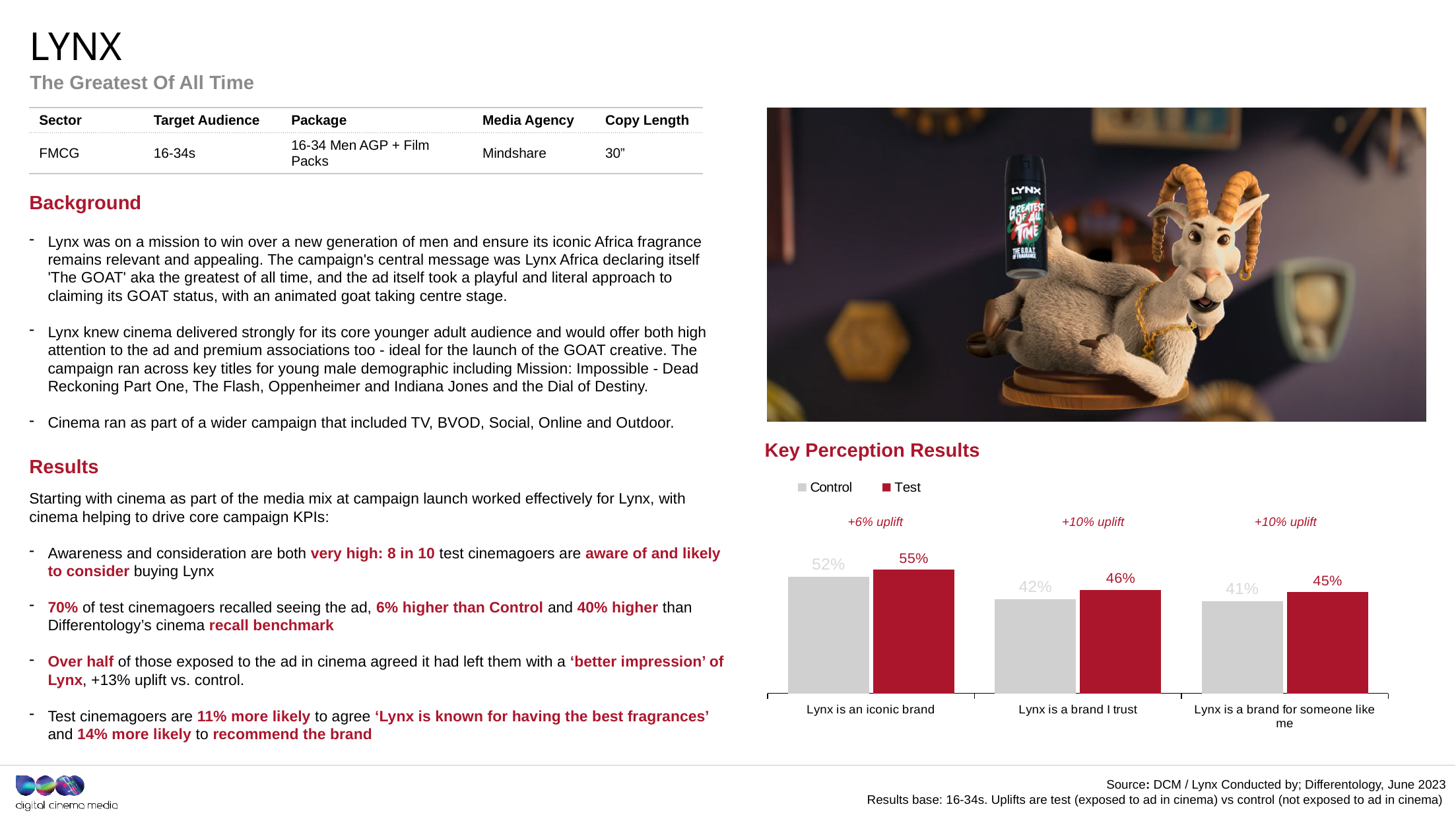
What kind of chart is shown under 'Key Perception Results'? Bar chart What is the difference between the Test and Control values for 'Lynx is a brand I trust'? 4% What is the Test value for 'Lynx is an iconic brand'? 55% What is the Control value for 'Lynx is an iconic brand'? 52% Which category has the highest Test value? Lynx is an iconic brand What uplift is shown above the 'Lynx is an iconic brand' bars? +6% uplift What is the Test value for 'Lynx is a brand for someone like me'? 45% How many series does the chart legend list? 2 Which category has the lowest Control value? Lynx is a brand for someone like me What is the Control value for 'Lynx is a brand I trust'? 42% How many categories are shown on the x axis of the chart? 3 Which is larger: the Test value for 'Lynx is a brand I trust' or the Test value for 'Lynx is a brand for someone like me'? Lynx is a brand I trust